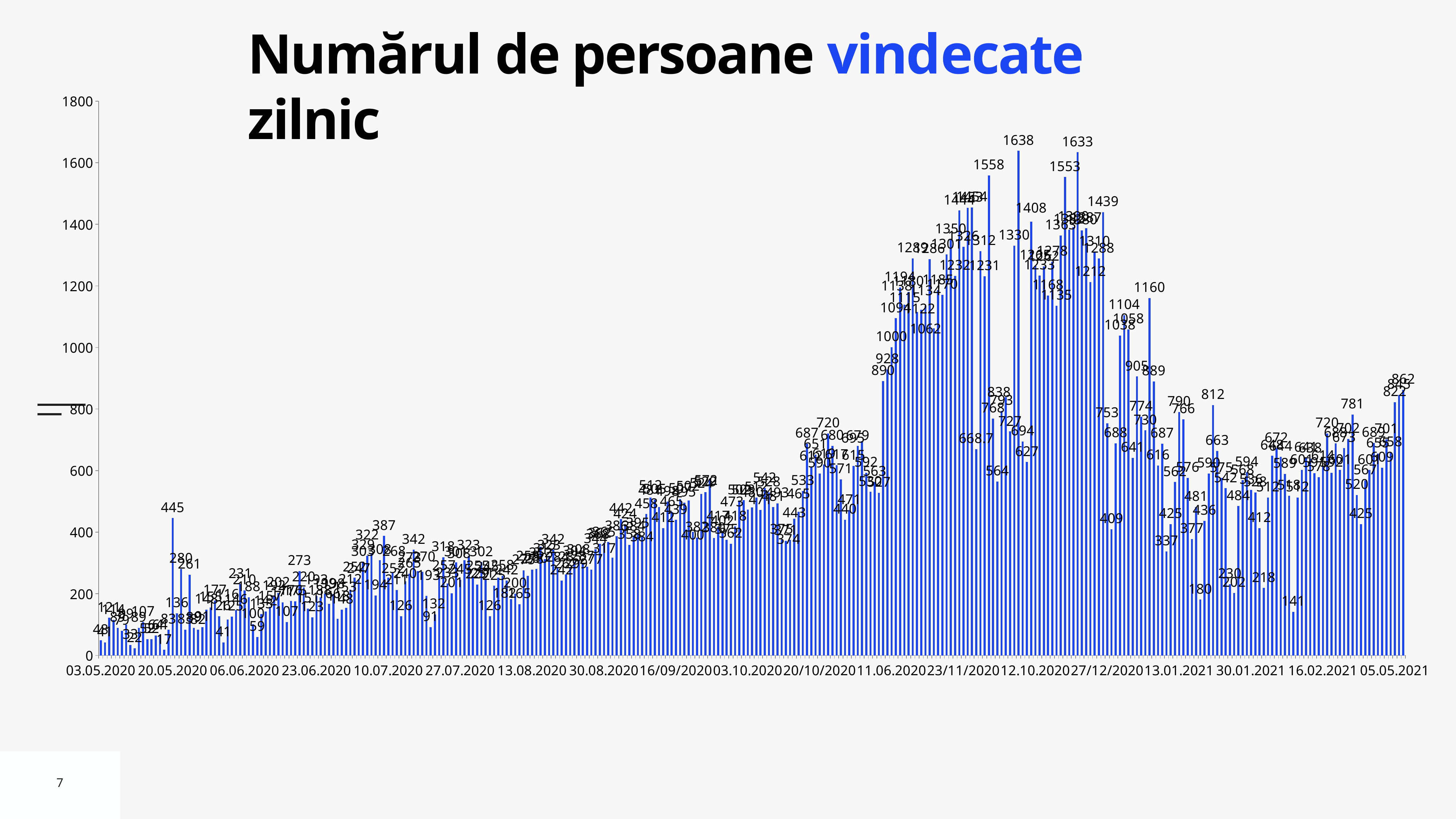
What is the first date label on the horizontal axis? 03.05.2020 What kind of chart is shown on the slide? bar chart What is the highest labelled value among the bars between 03.05.2020 and 06.06.2020? 445 What is the difference between the two highest labelled values, 1638 and 1633? 5 What is the highest tick value on the vertical axis? 1800 Do the values generally rise or fall from 03.05.2020 to 23/11/2020? rise What is the highest value labelled on the chart? 1638 Is the tallest bar greater or less than 1600? greater What is the title of the chart? Numărul de persoane vindecate zilnic What is the last date label on the horizontal axis? 05.05.2021 Is the last bar on the chart (05.05.2021) greater or less than 1000? less Which is larger, the bar labelled 1638 or the bar labelled 1558? 1638